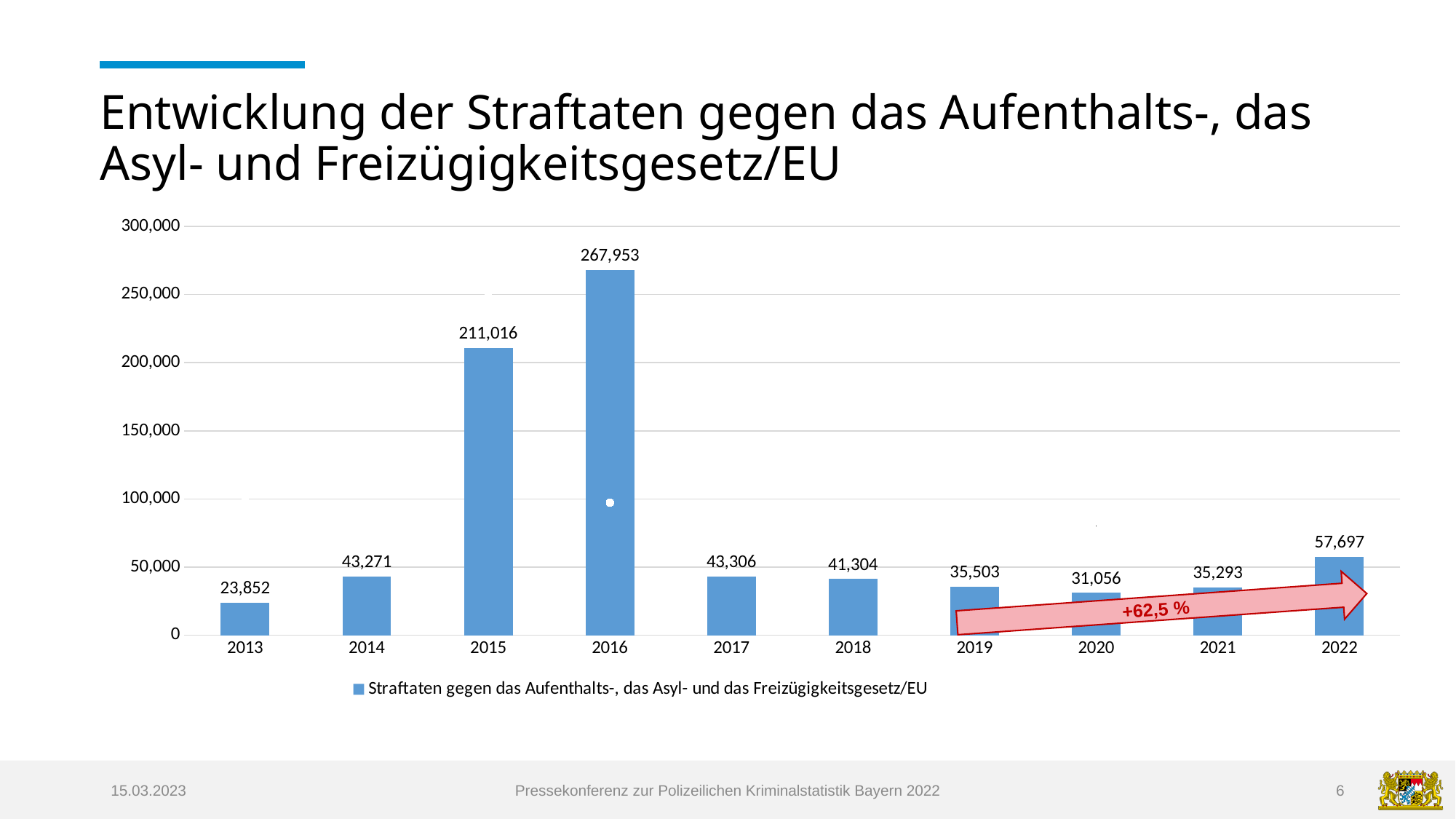
What kind of chart is shown on the slide? Bar chart What value is shown for 2016? 267,953 Which year has the larger value, 2019 or 2020? 2019 What value is shown for 2013? 23,852 Which year has the highest value? 2016 Is the value for 2022 greater or less than 50,000? greater What value is shown for 2022? 57,697 How many years are shown on the x axis? 10 What is the difference between the values for 2016 and 2015? 56,937 Which year has the lowest value? 2013 What is the difference between the values for 2022 and 2021? 22,404 How many series does the legend list? 1